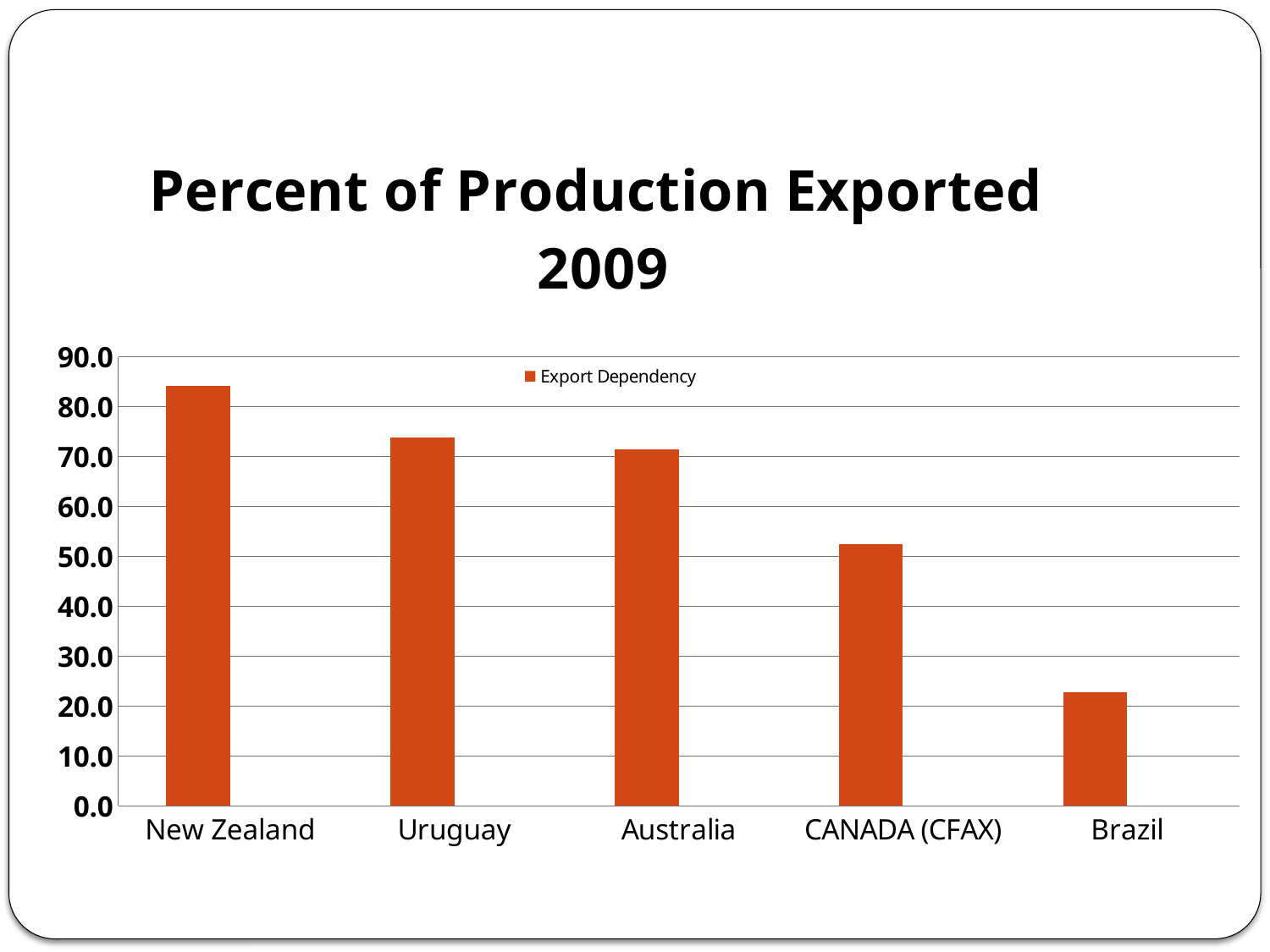
How many countries are shown on the x axis? 5 Is the value for CANADA (CFAX) greater or less than 50.0? greater What is the title of the chart? Percent of Production Exported 2009 Which country has the lowest export dependency? Brazil Is the value for New Zealand greater or less than 80.0? greater What is the name of the series in the legend? Export Dependency Which country has the highest export dependency? New Zealand How many series does the legend list? 1 What kind of chart is shown on the slide? bar chart Which has a larger value, Uruguay or CANADA (CFAX)? Uruguay Do the values rise or fall from left to right across the x axis? fall Is the value for Brazil greater or less than 30.0? less